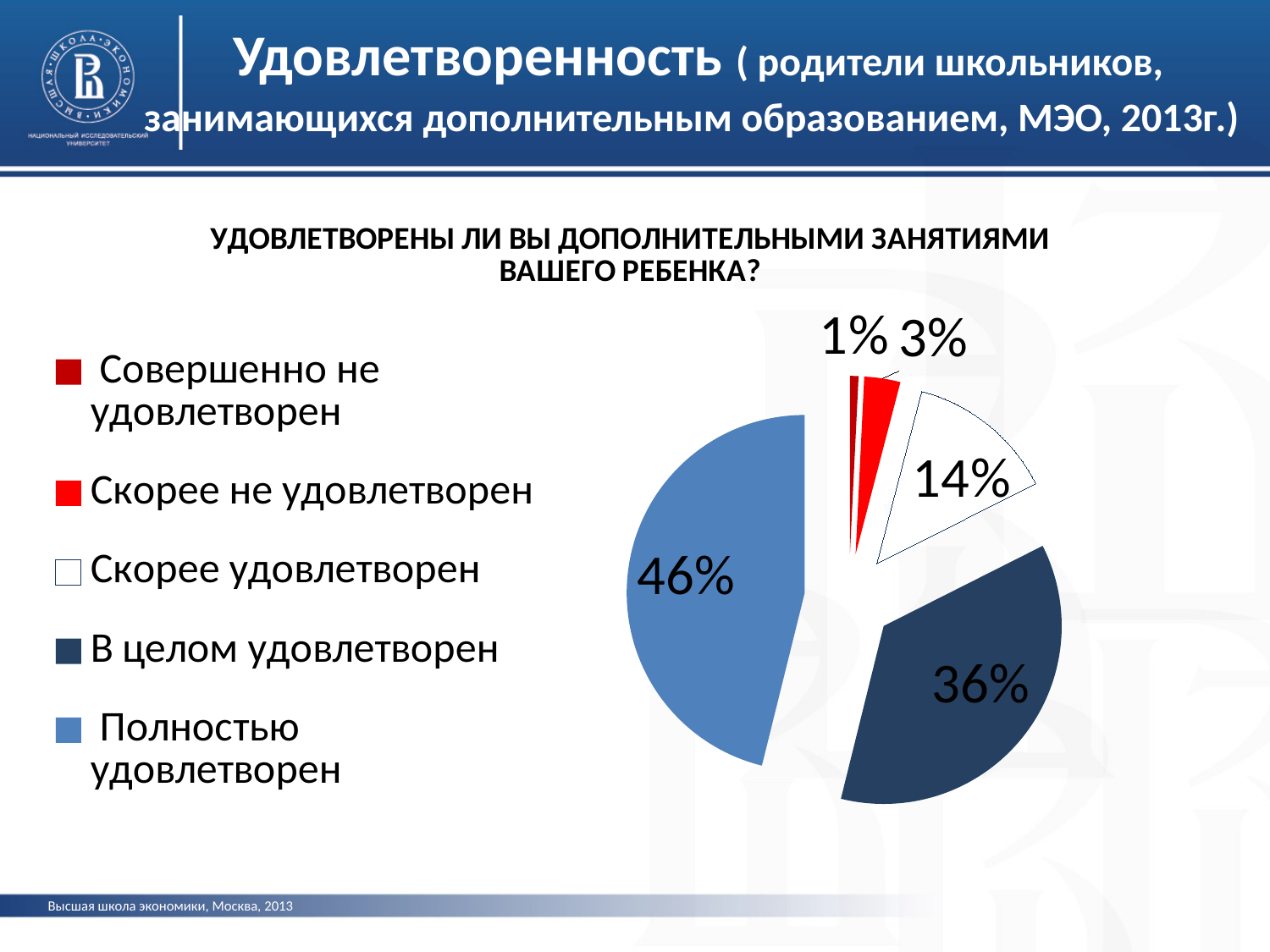
What colour is the slice for "Скорее удовлетворен"? white What share of parents answered "Скорее удовлетворен"? 14% What share of parents answered "В целом удовлетворен"? 36% How many answer categories does the legend list? 5 What kind of chart is shown on the slide? pie chart What share of parents answered "Скорее не удовлетворен"? 3% Which answer category has the largest share of the pie? Полностью удовлетворен Which is larger: the share for "Скорее удовлетворен" or the share for "Скорее не удовлетворен"? Скорее удовлетворен What share of parents answered "Полностью удовлетворен"? 46% What share of parents answered "Совершенно не удовлетворен"? 1% What is the difference in percentage points between "Полностью удовлетворен" and "В целом удовлетворен"? 10 percentage points Which answer category has the smallest share of the pie? Совершенно не удовлетворен